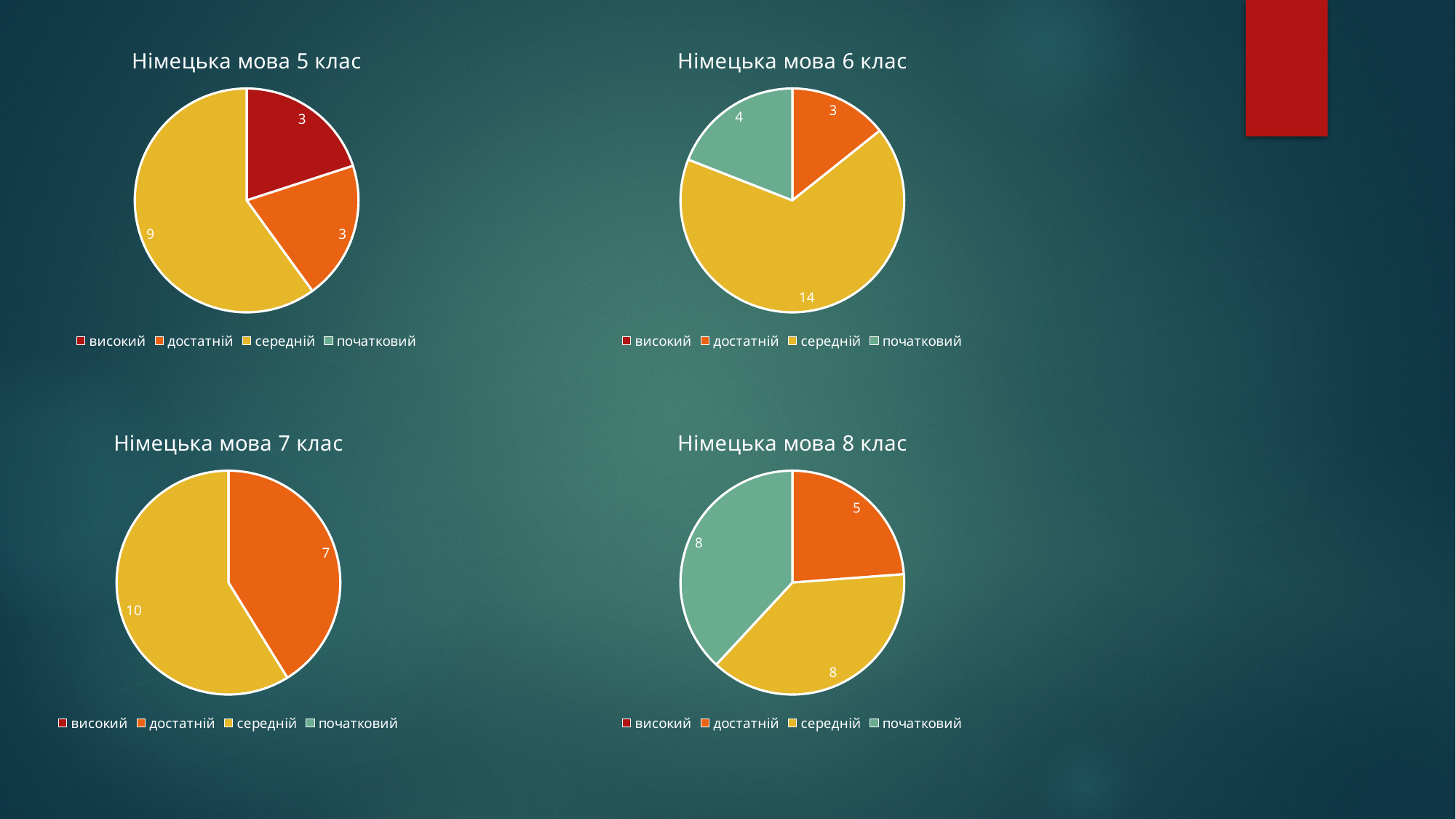
In the chart titled "Німецька мова 8 клас", which category has the smallest slice? достатній In the chart titled "Німецька мова 7 клас", what is the value for достатній? 7 What kind of chart is the chart titled "Німецька мова 5 клас"? pie chart In the chart titled "Німецька мова 8 клас", what is the value for достатній? 5 In the chart titled "Німецька мова 7 клас", which is larger, середній or достатній? середній In the chart titled "Німецька мова 6 клас", what is the difference between the values for середній and початковий? 10 In the chart titled "Німецька мова 6 клас", what is the value for початковий? 4 How many entries does the legend of the chart titled "Німецька мова 8 клас" list? 4 In the chart titled "Німецька мова 6 клас", which category has the largest slice? середній How many slices does the chart titled "Німецька мова 7 клас" show? 2 In the chart titled "Німецька мова 5 клас", what is the value for середній? 9 In the chart titled "Німецька мова 5 клас", what share of the pie does високий represent? 20%